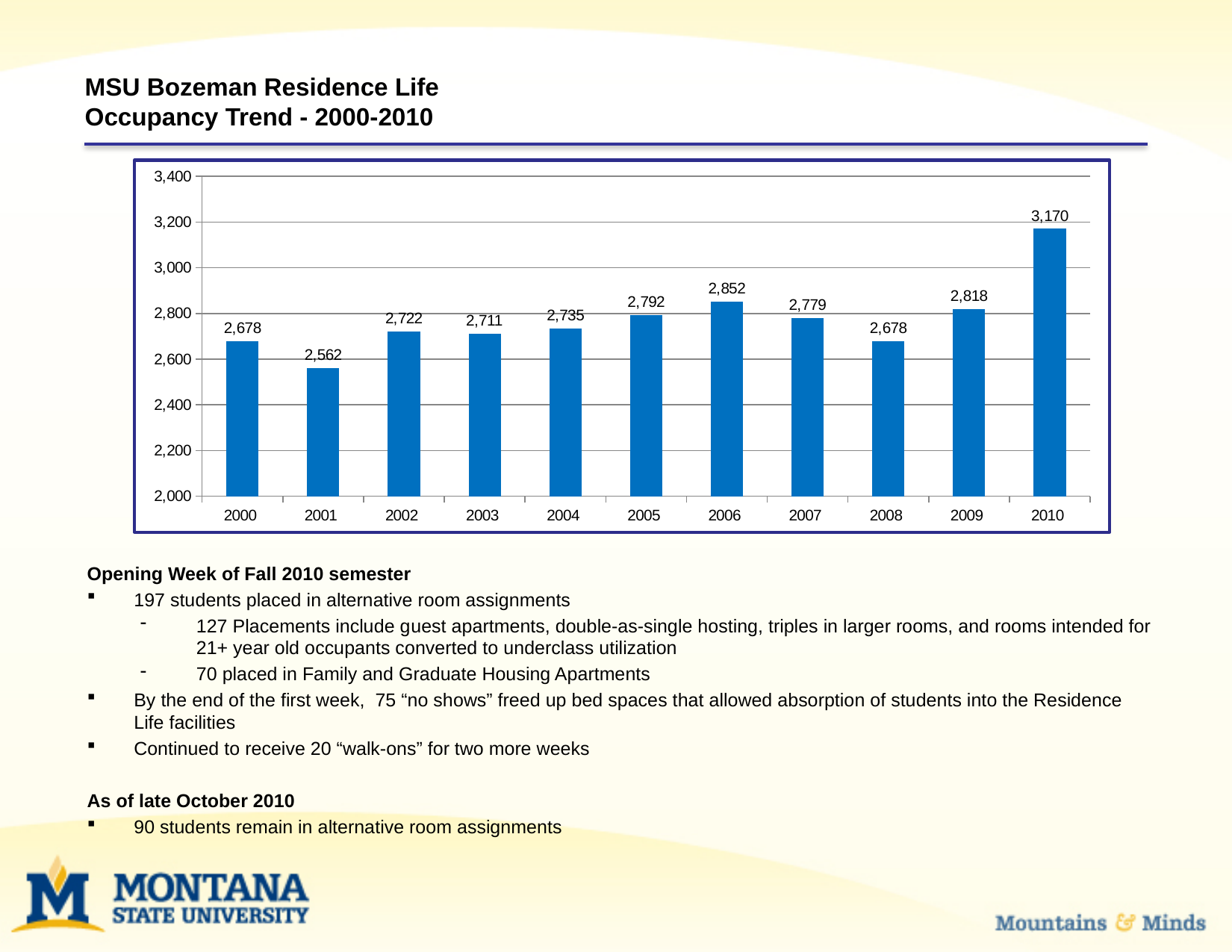
What is the occupancy value for 2006? 2,852 Does the occupancy rise or fall from 2008 to 2010? Rise Which year has the larger occupancy, 2005 or 2007? 2005 What is the difference between the occupancy in 2006 and in 2008? 174 What is the difference between the occupancy in 2010 and in 2009? 352 Is the value for 2004 greater or less than 2,800? less What is the occupancy value for 2001? 2,562 Which year has the highest occupancy? 2010 What is the occupancy value for 2010? 3,170 How many years are shown on the x axis? 11 Which year has the lowest occupancy? 2001 What kind of chart is shown on the slide? Bar chart